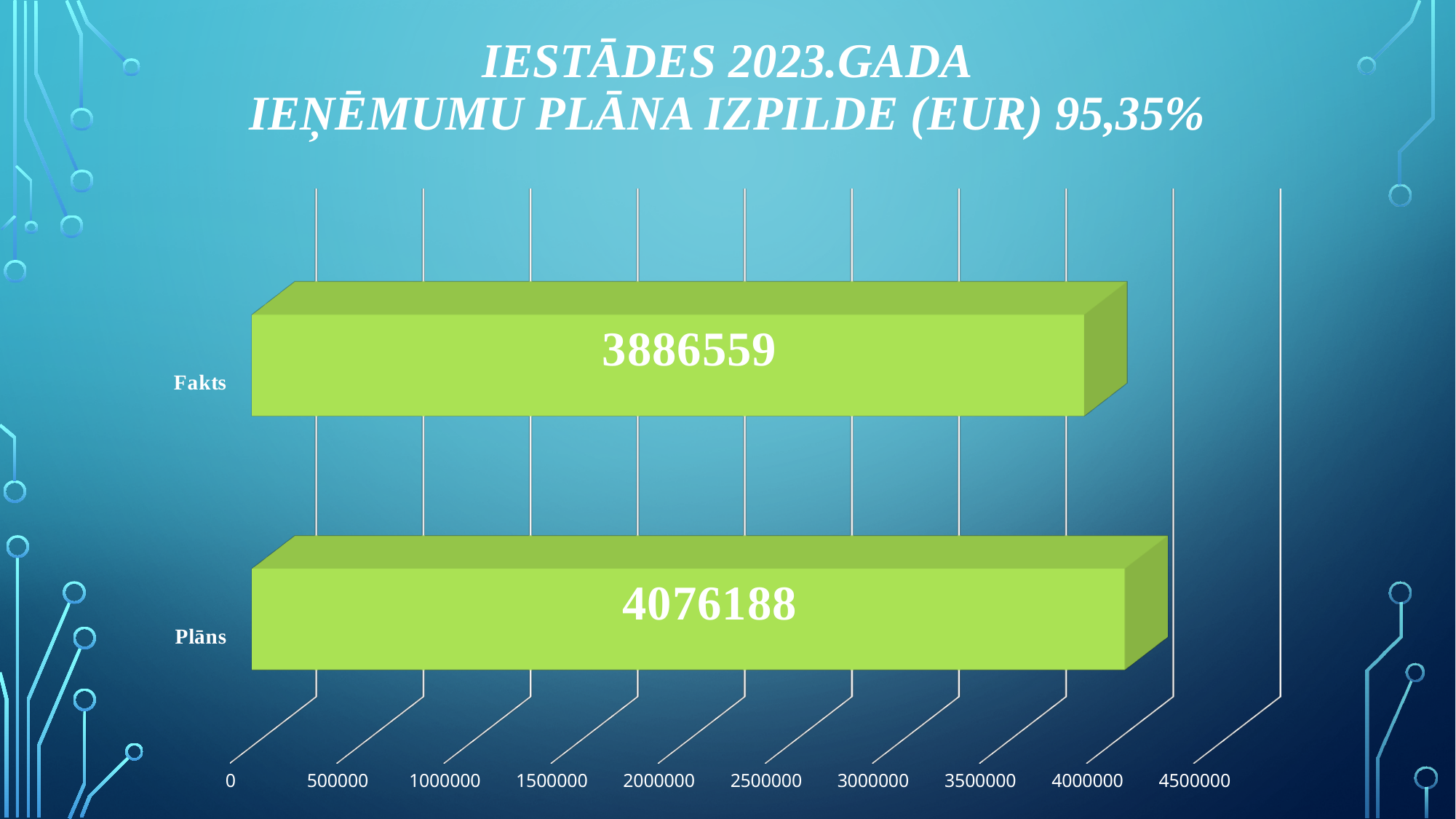
Is the value for Fakts greater or less than 4000000? less Is the value for Plāns greater or less than 4000000? greater What is the value for Plāns? 4076188 What is the value for Fakts? 3886559 Which is larger, the value for Fakts or the value for Plāns? Plāns What is the highest value labelled on the horizontal axis? 4500000 Which category has the lowest value? Fakts Which category has the highest value? Plāns What is the difference between the Plāns and Fakts values? 189629 What kind of chart is shown on the slide? bar chart How many categories are shown in the chart? 2 What percentage is stated in the chart title? 95,35%